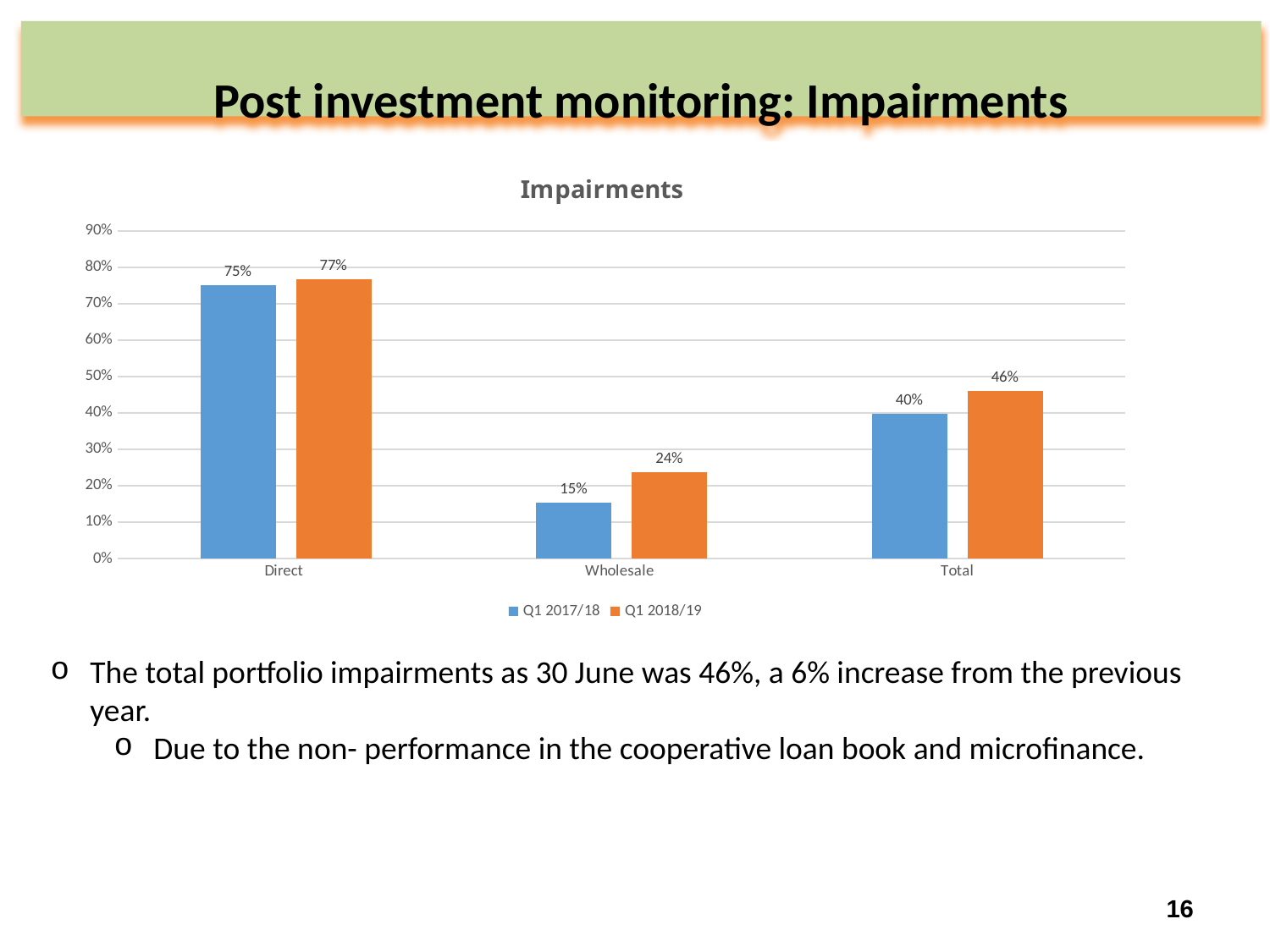
What is the difference between the Q1 2018/19 and Q1 2017/18 values for Total? 6% What is the title of the chart? Impairments Which category has the highest impairment value in Q1 2018/19? Direct How many series does the legend list? 2 What kind of chart is shown on the slide? Bar chart What is the impairment value for Direct in Q1 2017/18? 75% What is the Total impairment value for Q1 2018/19? 46% Which category has the lowest impairment value in Q1 2017/18? Wholesale Which is larger: the Direct value for Q1 2017/18 or the Direct value for Q1 2018/19? Q1 2018/19 What is the impairment value for Wholesale in Q1 2018/19? 24% What is the difference between the Q1 2018/19 and Q1 2017/18 values for Wholesale? 9% How many categories are shown on the x axis of the chart? 3